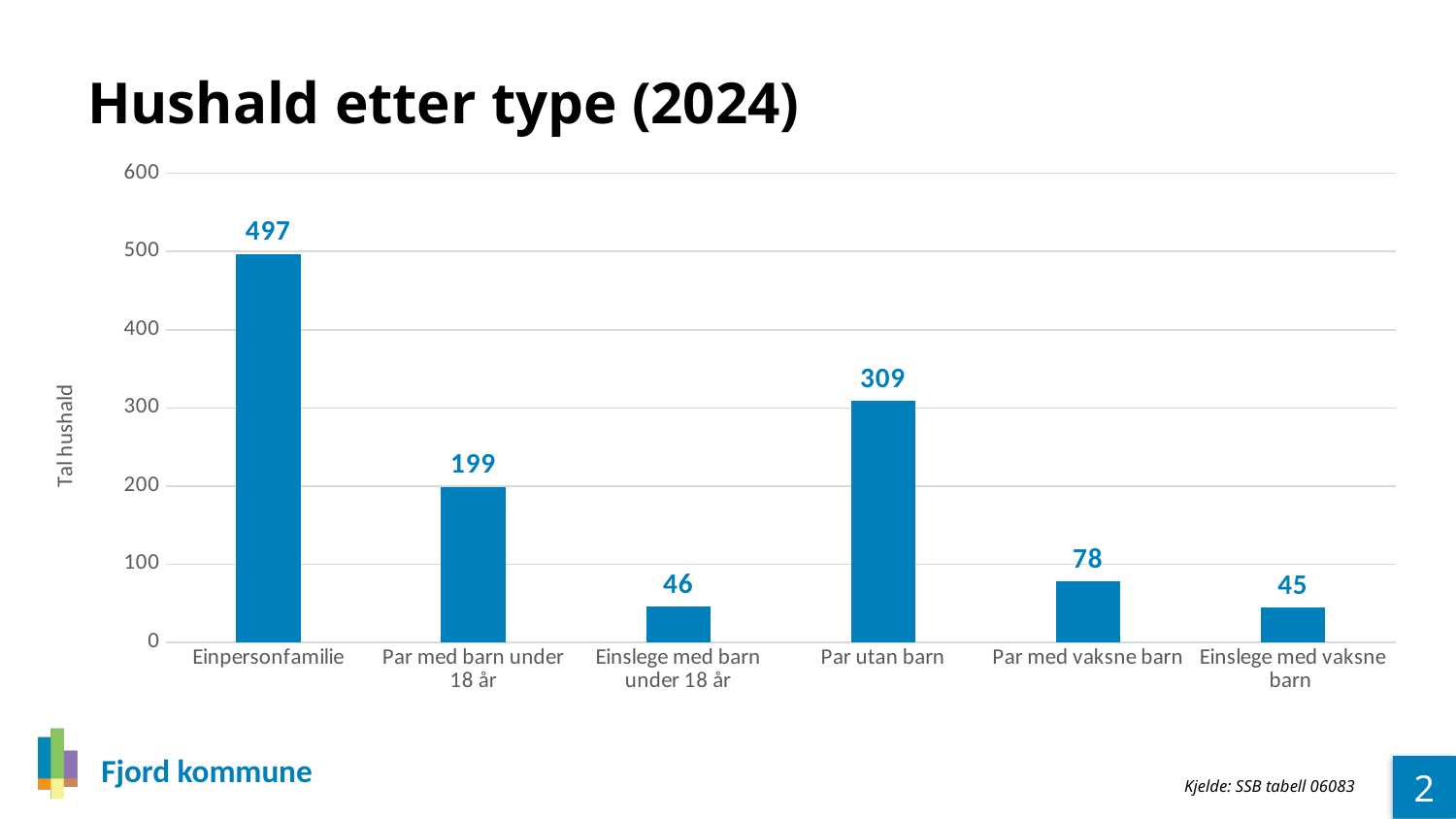
What is the difference between Par med barn under 18 år and Par med vaksne barn? 121 Which household type has the lowest value? Einslege med vaksne barn How many household types are shown on the chart? 6 Which household type has the highest value? Einpersonfamilie What is the value for Par utan barn? 309 What is the value for Par med vaksne barn? 78 What is the difference between Einpersonfamilie and Par utan barn? 188 What is the value for Einpersonfamilie? 497 What is the title of the chart? Hushald etter type (2024) Is the value for Par utan barn greater or less than 300? greater Which is larger, Par med barn under 18 år or Par utan barn? Par utan barn What kind of chart is shown on the slide? Bar chart